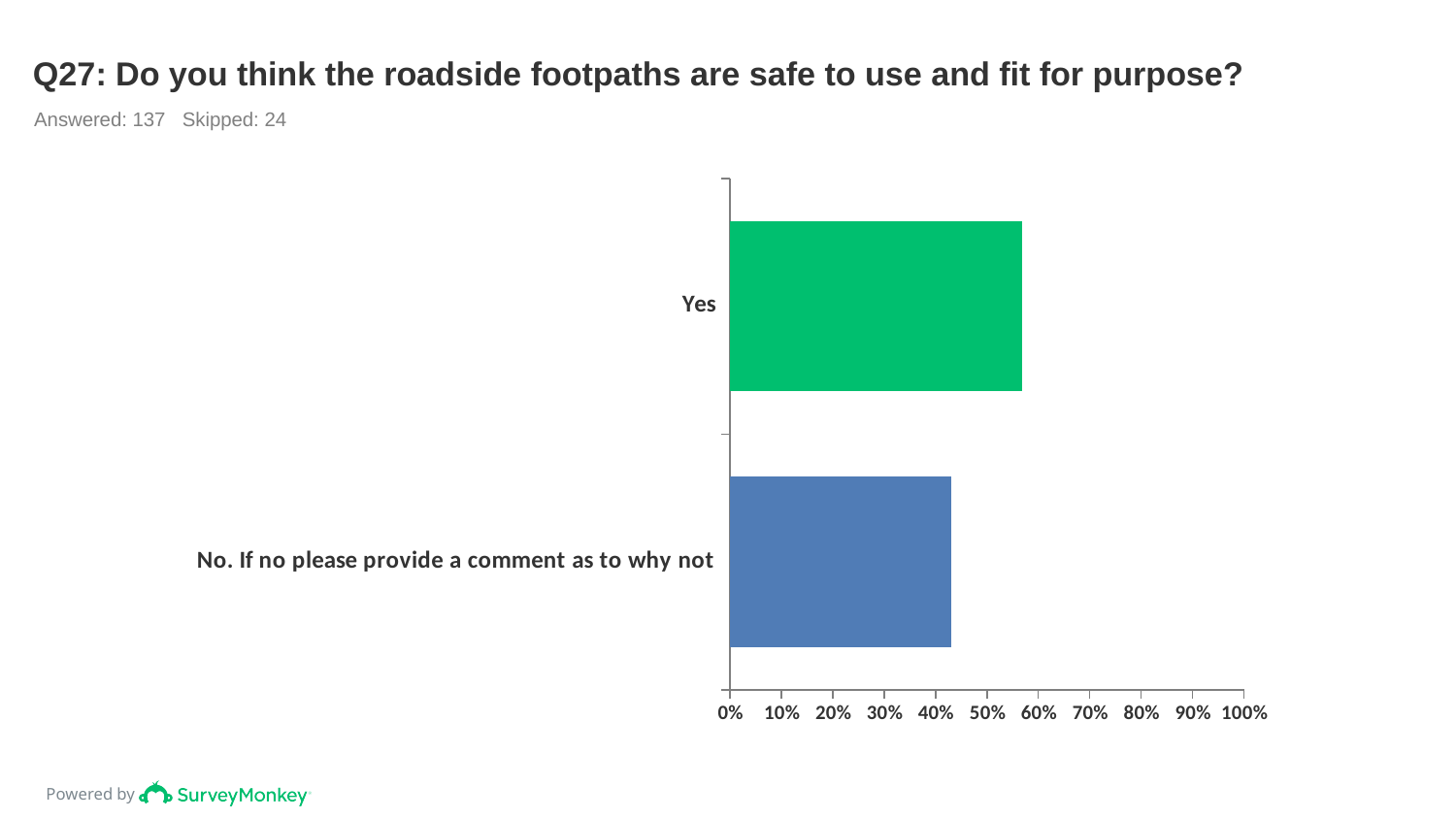
Which category has the lowest value? No. If no please provide a comment as to why not Is the value for Yes greater or less than 50%? greater Is the value for "No. If no please provide a comment as to why not" greater or less than 40%? greater What colour is the bar for Yes? green Is the value for Yes greater or less than 60%? less What is the title of the chart? Q27: Do you think the roadside footpaths are safe to use and fit for purpose? What kind of chart is shown on the slide? bar chart How many categories are plotted in the chart? 2 What is the maximum value shown on the x axis? 100% Which category has the highest value? Yes Which is larger, the value for Yes or the value for No? Yes